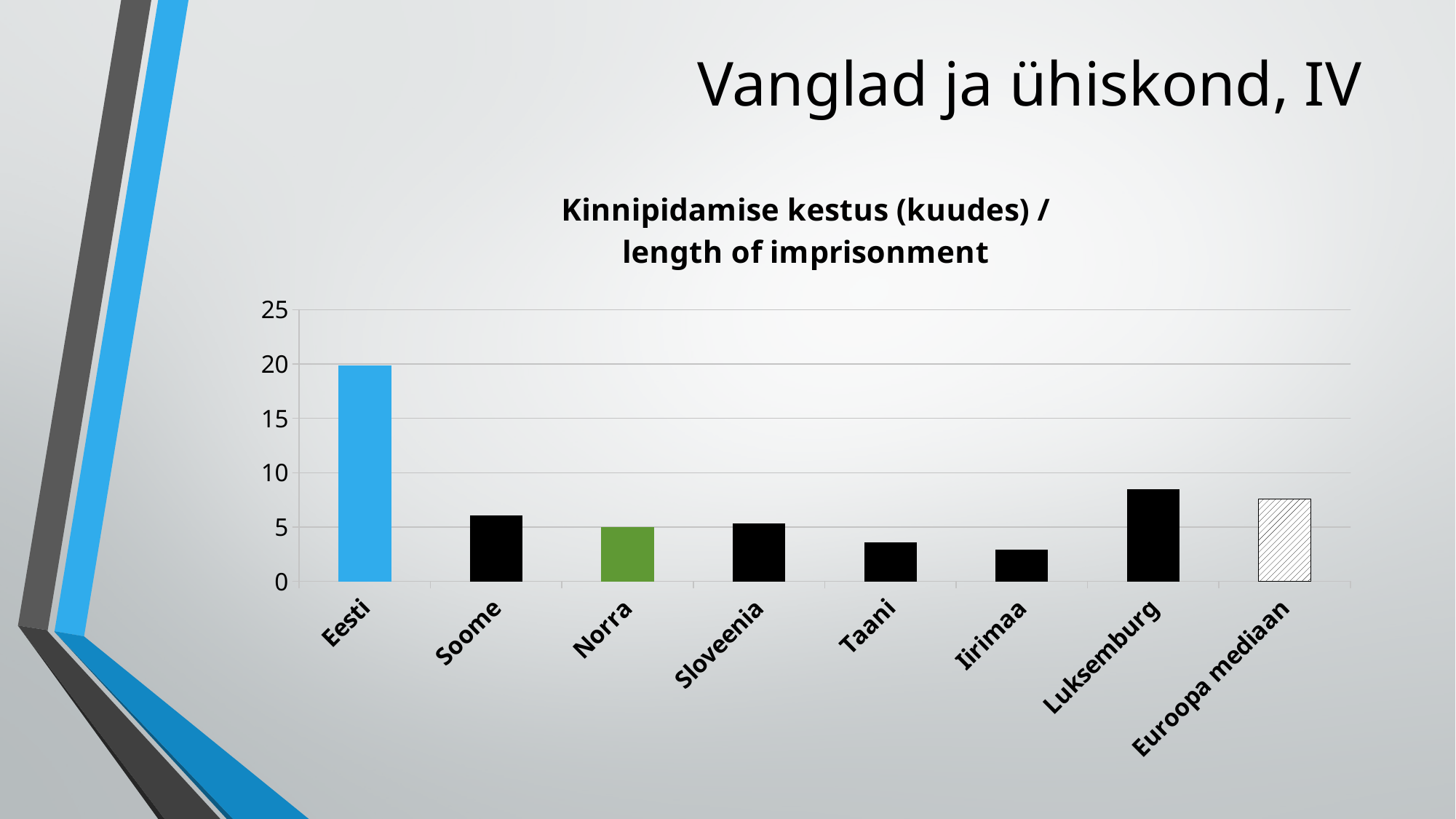
Which has a larger value, Luksemburg or Euroopa mediaan? Luksemburg Which has a larger value, Soome or Taani? Soome Is the value for Euroopa mediaan greater or less than 10? less Which category has the lowest value in the chart? Iirimaa What is the title of the chart? Kinnipidamise kestus (kuudes) / length of imprisonment What kind of chart is shown on the slide? bar chart Is the value for Luksemburg greater or less than 5? greater What colour is the bar for Norra? green How many categories are shown on the x axis of the chart? 8 Is the value for Eesti greater or less than 15? greater Which category has the highest value in the chart? Eesti